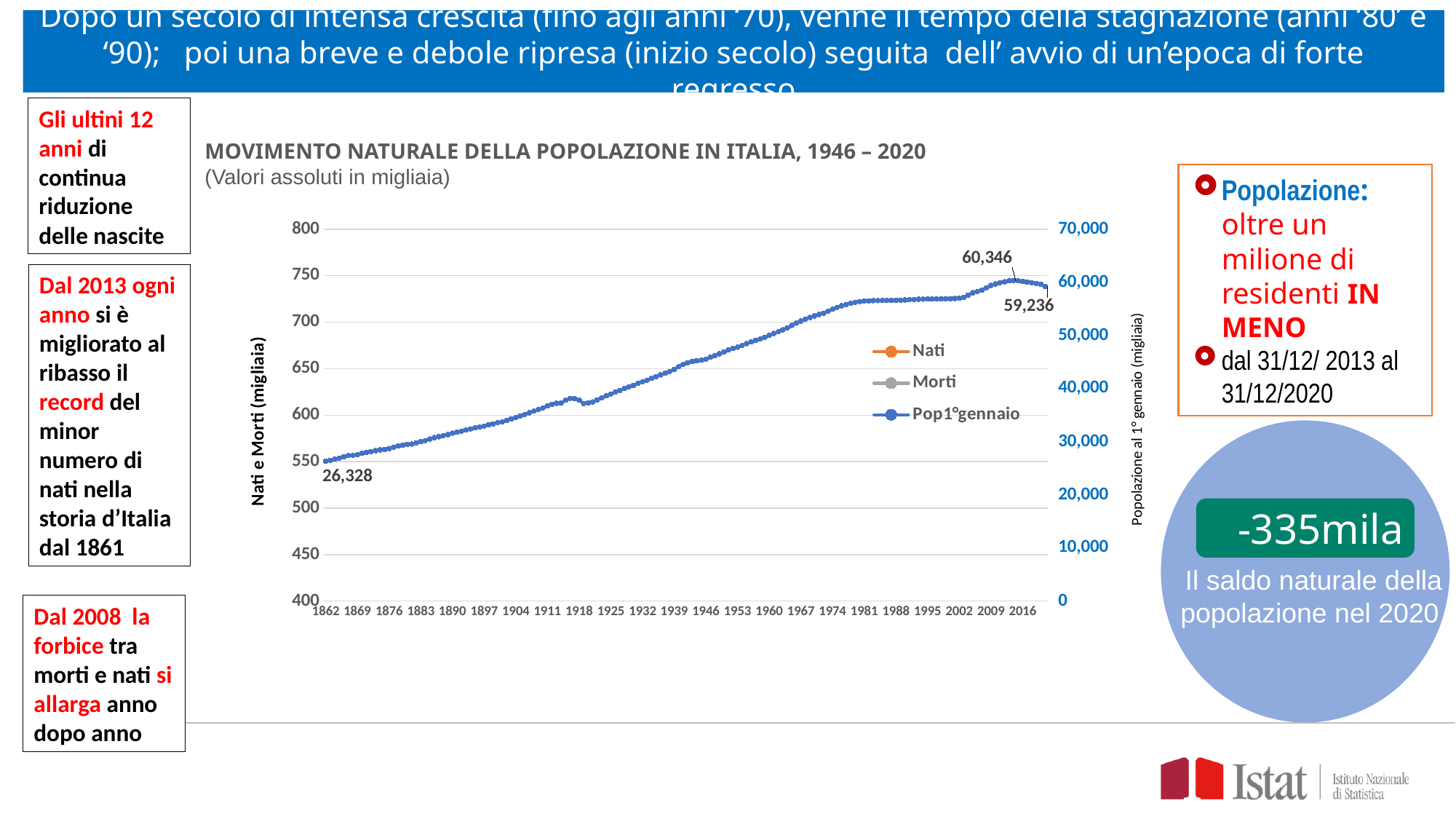
What is the last data label shown at the end of the Pop1°gennaio line? 59,236 How many series does the chart legend list? 3 What is the peak value labelled on the Pop1°gennaio line? 60,346 What is the difference between the labelled values 60,346 and 26,328 on the Pop1°gennaio line? 34,018 Which labelled value is larger, 60,346 or 59,236? 60,346 Is the Pop1°gennaio value around 2016 greater or less than 50,000 on the right axis? greater What is the difference between the labelled peak value 60,346 and the final labelled value 59,236? 1,110 What is the title of the chart? MOVIMENTO NATURALE DELLA POPOLAZIONE IN ITALIA, 1946 – 2020 What kind of chart is shown on the slide? line chart What is the label of the right-hand vertical axis? Popolazione al 1° gennaio (migliaia) Does the Pop1°gennaio line generally rise or fall from 1862 to the 2010s? rise What is the data label shown at the start of the Pop1°gennaio line (1862)? 26,328